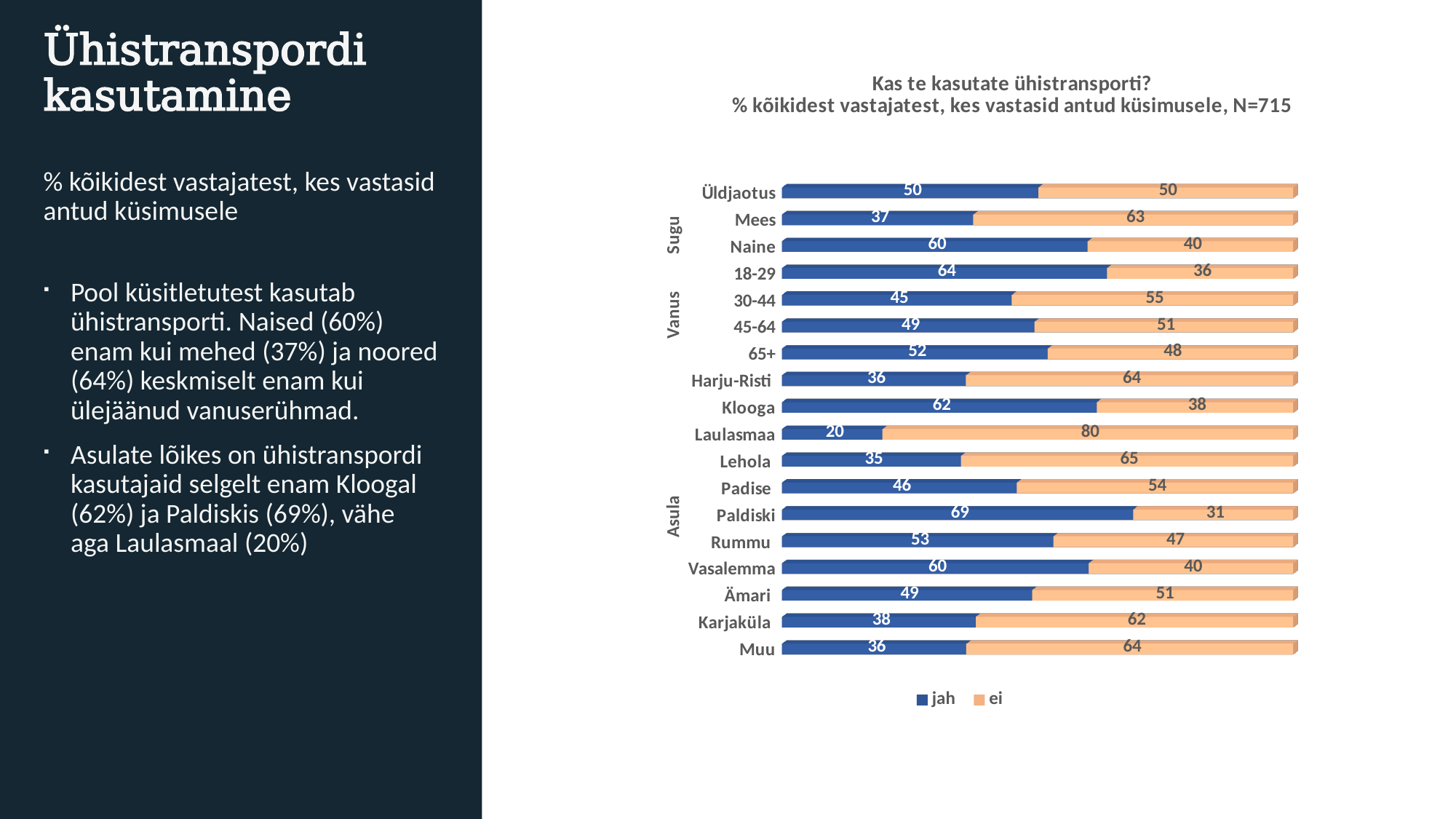
What kind of chart is shown on the slide? Stacked bar chart How many series does the legend list? 2 What is the difference between the 'jah' values for Naine and Mees? 23 Which category has the highest 'jah' value? Paldiski What is the 'ei' value for Laulasmaa? 80 What is the 'jah' value for Paldiski? 69 What is the total of the stacked bar for 18-29? 100 What are the two series listed in the legend? jah and ei What is the 'jah' value for Naine? 60 Which has a larger 'jah' value, Klooga or Harju-Risti? Klooga How many categories are shown on the chart? 18 Which category has the lowest 'jah' value? Laulasmaa